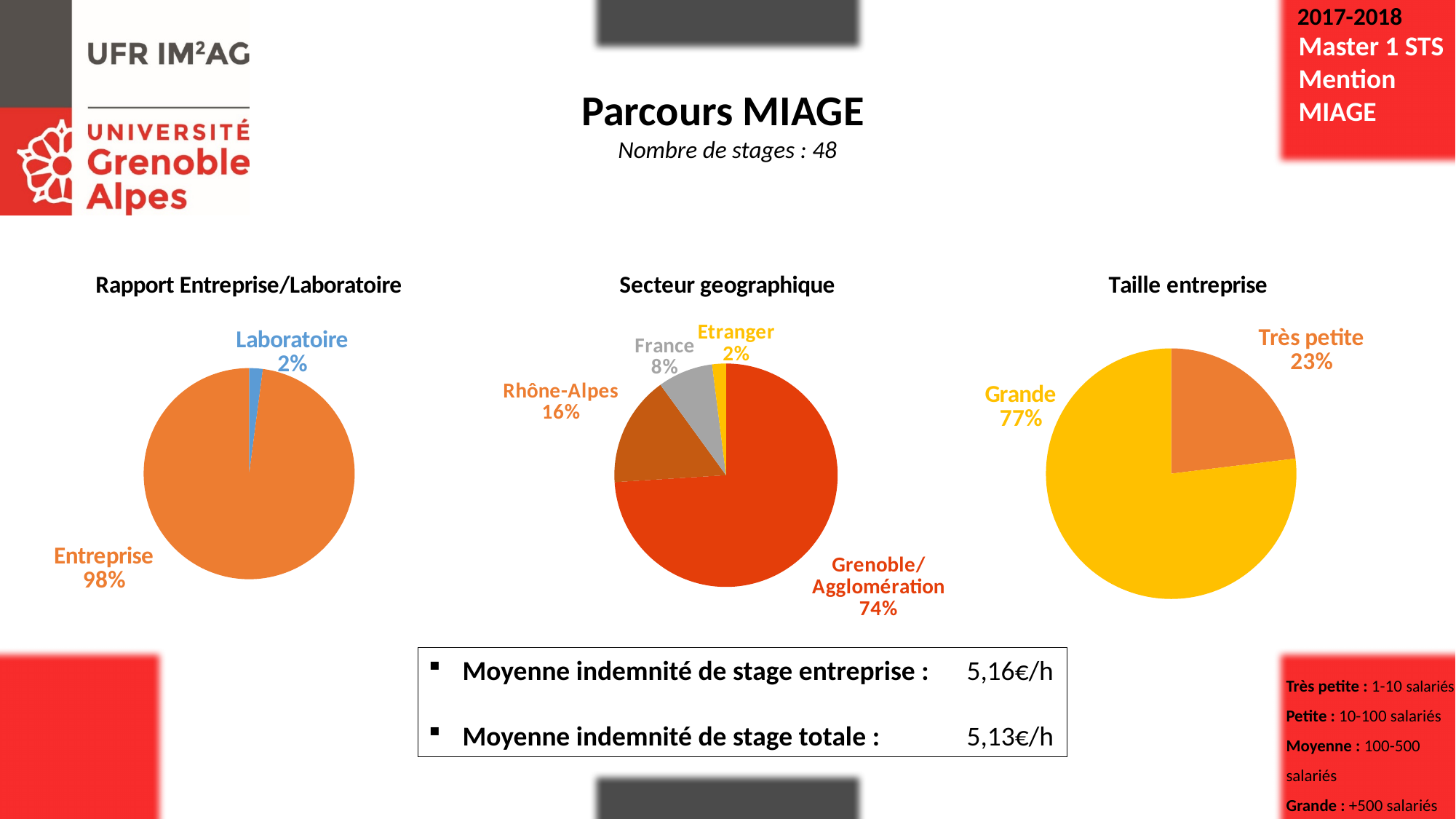
In the 'Secteur geographique' chart, which category has the smallest share? Etranger In the 'Secteur geographique' chart, how many categories are shown? 4 In the 'Secteur geographique' chart, what is the difference between the shares of Rhône-Alpes and France? 8% In the 'Taille entreprise' chart, what share does Grande have? 77% In the 'Rapport Entreprise/Laboratoire' chart, what share does Entreprise have? 98% In the 'Taille entreprise' chart, what is the difference between the shares of Grande and Très petite? 54% In the 'Secteur geographique' chart, which category has the largest share? Grenoble/Agglomération In the 'Taille entreprise' chart, which is larger, Grande or Très petite? Grande What kind of chart is the 'Taille entreprise' chart? Pie chart In the 'Rapport Entreprise/Laboratoire' chart, what share does Laboratoire have? 2%